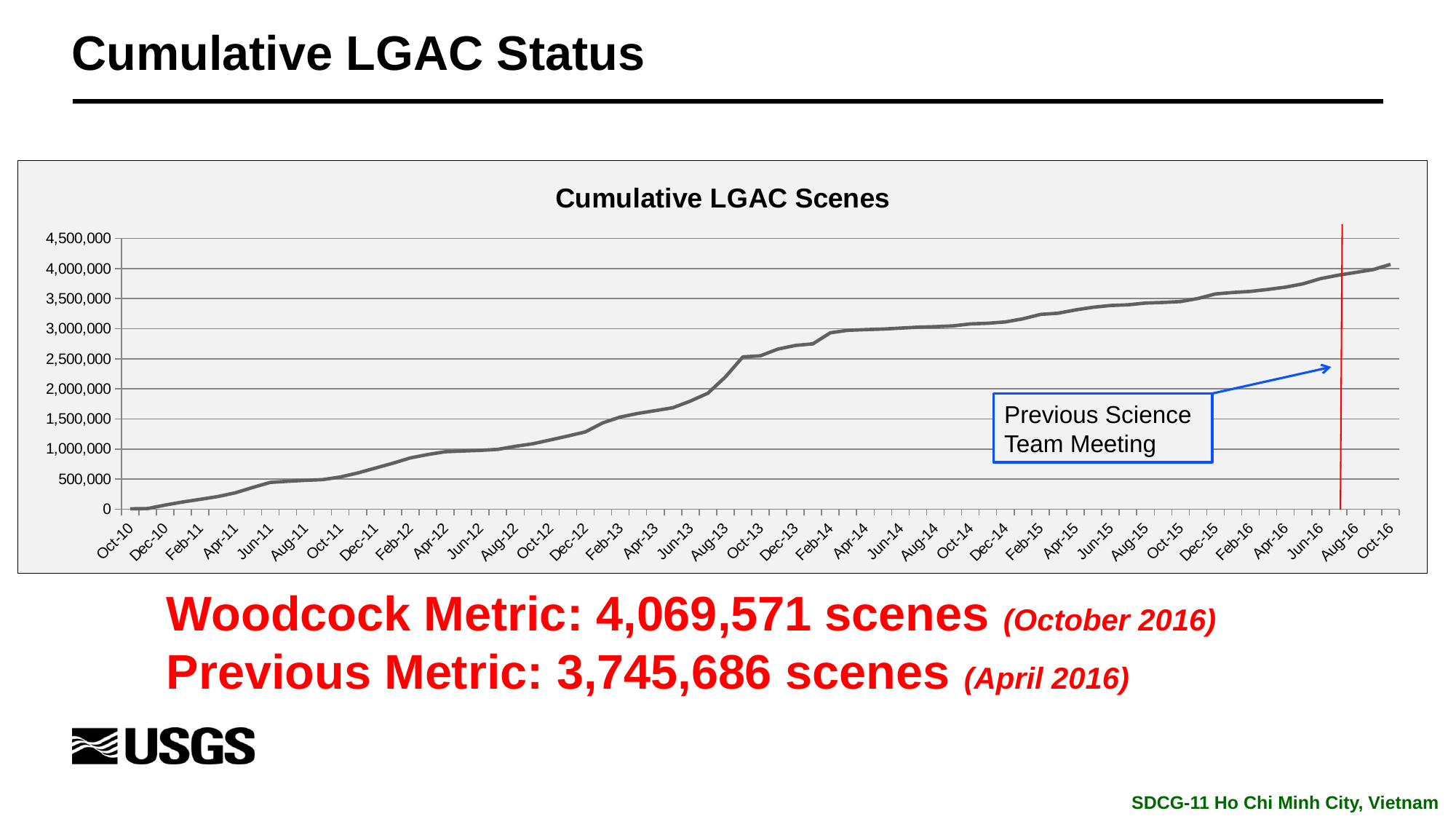
At which x-axis label does the line reach its highest value? Oct-16 Is the value for Oct-16 greater or less than 4,000,000? greater Which is larger, the value for Oct-13 or the value for Oct-12? Oct-13 What is the title of the chart? Cumulative LGAC Scenes Do the values in the chart rise or fall from Oct-10 to Oct-16? rise Is the value for Dec-12 greater or less than 1,000,000? greater Is the value for Jun-15 greater or less than 3,000,000? greater What does the text box with the blue arrow on the chart say? Previous Science Team Meeting At which x-axis label is the line at its lowest value? Oct-10 According to the slide, how many cumulative scenes were there in October 2016? 4,069,571 scenes What kind of chart is shown on the slide? line chart